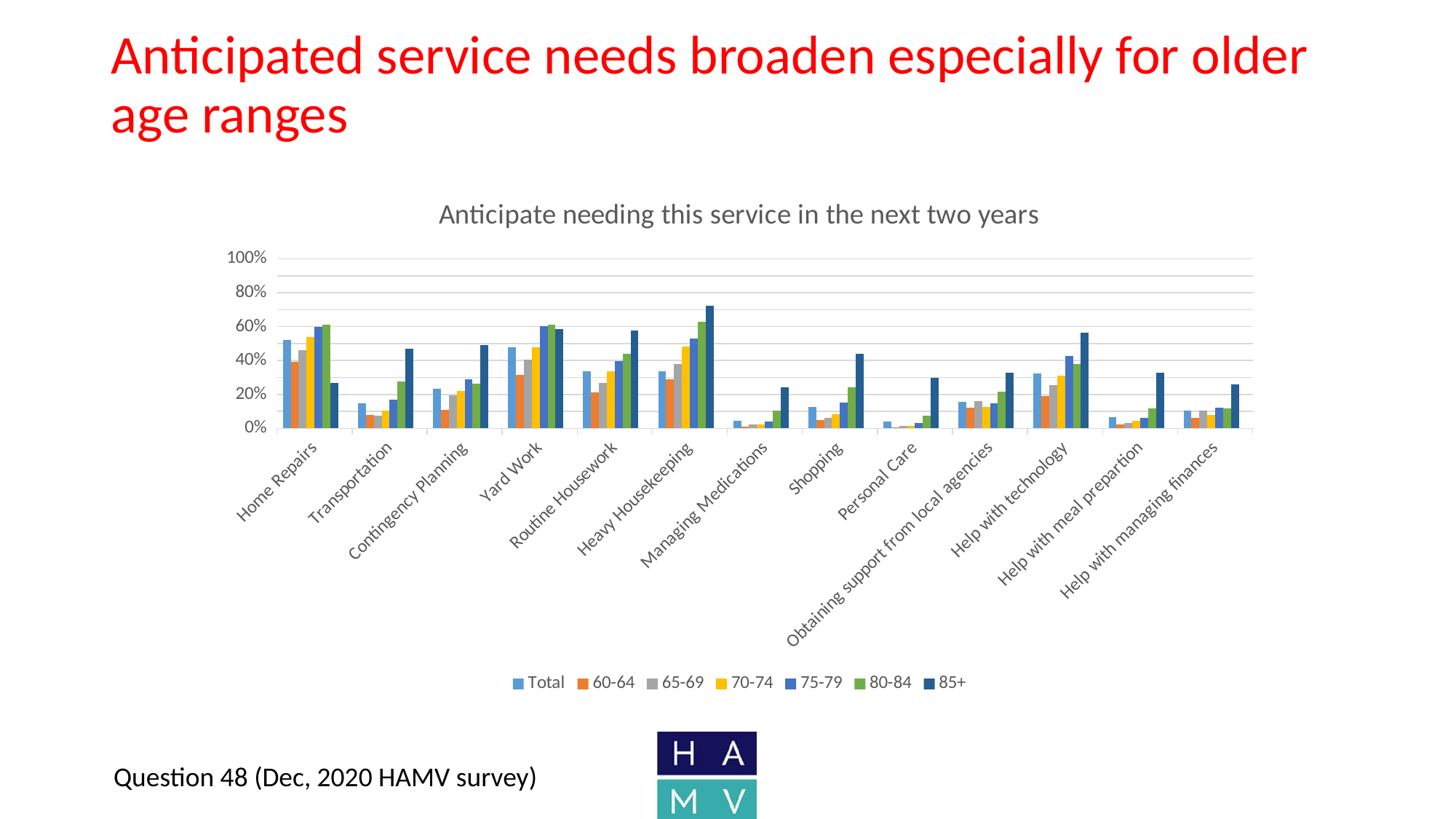
Which is larger: the 85+ value for Heavy Housekeeping or the 85+ value for Managing Medications? Heavy Housekeeping How many service categories are shown on the x axis of the chart? 13 How many series does the chart's legend list? 7 Is the value for the 85+ series for Heavy Housekeeping greater or less than 60%? greater Which service category has the highest value for the 85+ series? Heavy Housekeeping What is the title of the chart? Anticipate needing this service in the next two years Is the value for the Total series for Managing Medications greater or less than 20%? less Is the value for the 85+ series for Transportation greater or less than 40%? greater What kind of chart is shown on the slide? bar chart For Heavy Housekeeping, which age series has the highest value? 85+